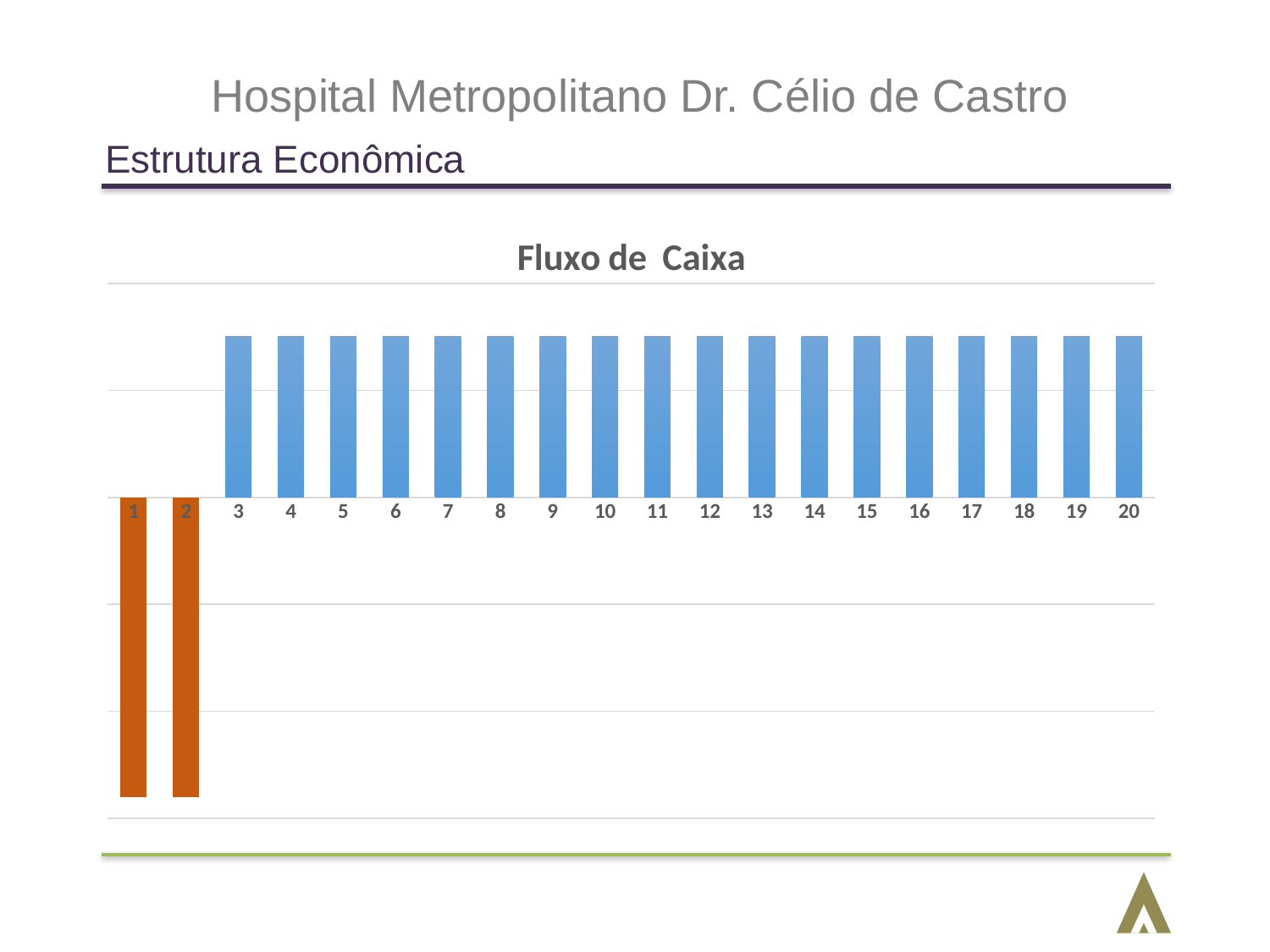
Do the values rise or fall from category 2 to category 3? Rise How many bars in the chart extend below the horizontal axis (negative values)? 2 Which is larger, the value for category 2 or the value for category 5? Category 5 How many bars in the chart extend above the horizontal axis (positive values)? 18 Which is larger, the value for category 1 or the value for category 20? Category 20 Which categories in the chart have negative values? 1 and 2 How many categories are shown on the x axis of the chart? 20 Do the values rise, fall or stay flat from category 3 to category 20? Stay flat What kind of chart is shown on the slide? Bar chart What is the title of the chart? Fluxo de Caixa